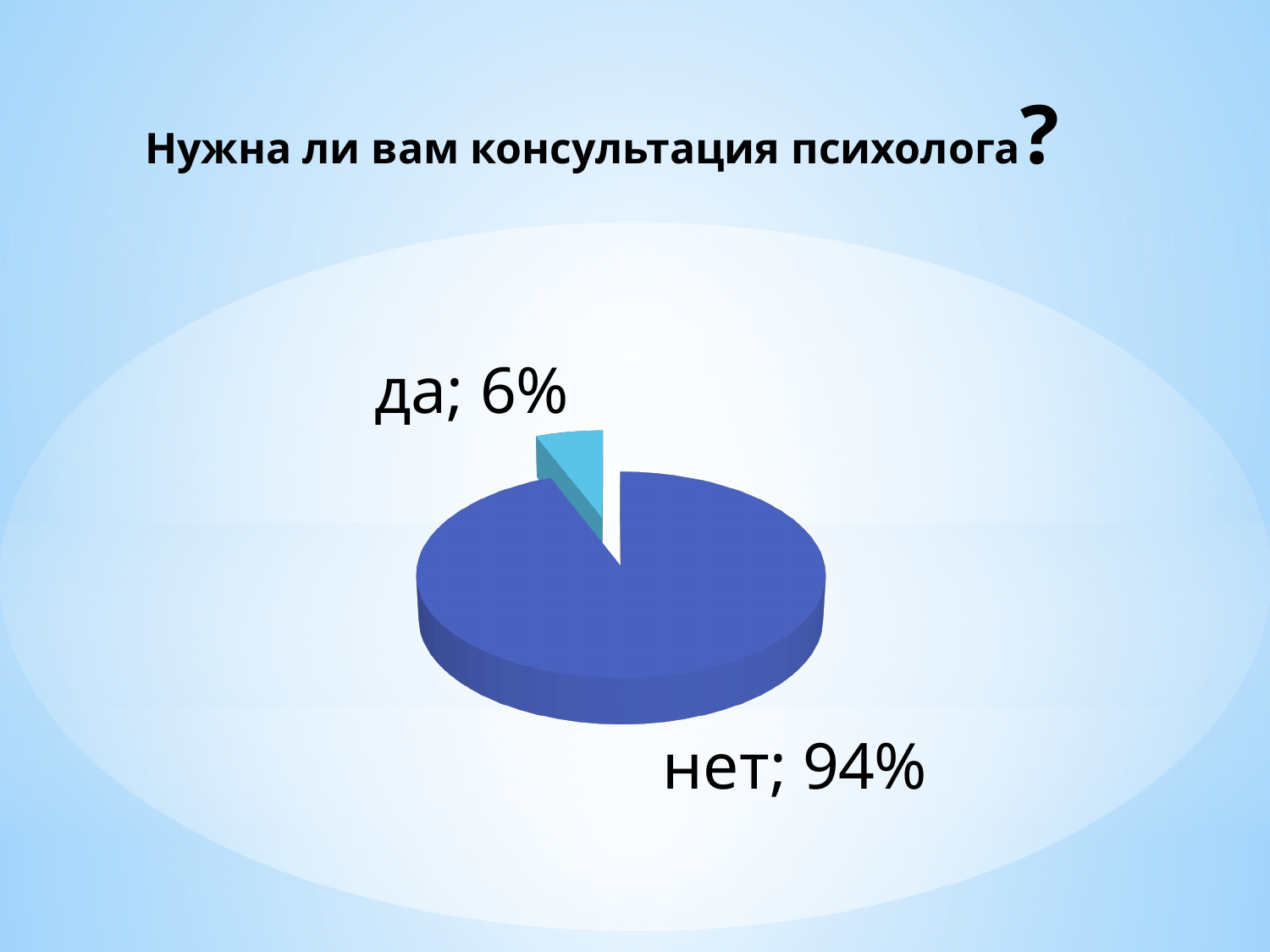
Which is larger, the share for "да" or the share for "нет"? нет How many slices does the pie chart have? 2 What colour is the "да" slice? light blue What is the difference in percentage points between "нет" and "да"? 88 What share of the pie does "да" represent? 6% Which slice is the smallest? да Which slice is the largest? нет What kind of chart is shown on the slide? pie chart What question is the chart titled with? Нужна ли вам консультация психолога? What share of the pie does "нет" represent? 94%